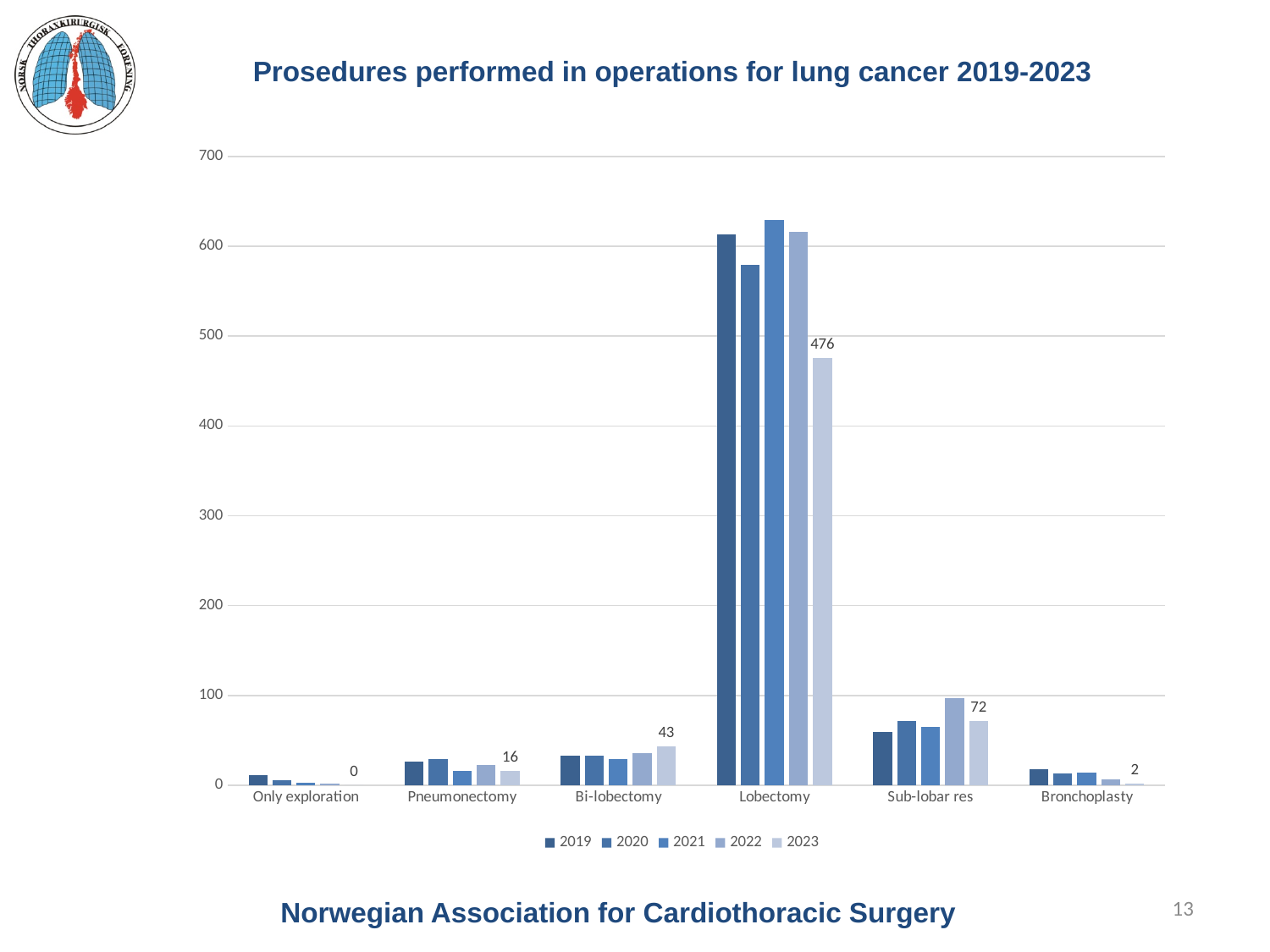
How many procedure categories are shown on the x axis? 6 Which procedure category has the lowest value in 2023? Only exploration Is the value for Lobectomy in 2021 greater or less than 600? greater What is the value for Lobectomy in 2023? 476 What is the difference between the 2023 values for Lobectomy and Sub-lobar res? 404 In 2023, which is larger: Sub-lobar res or Bi-lobectomy? Sub-lobar res What is the value for Only exploration in 2023? 0 What is the value for Sub-lobar res in 2023? 72 What is the value for Bi-lobectomy in 2023? 43 How many series does the legend list? 5 Which procedure category has the highest values across all years? Lobectomy What is the value for Pneumonectomy in 2023? 16